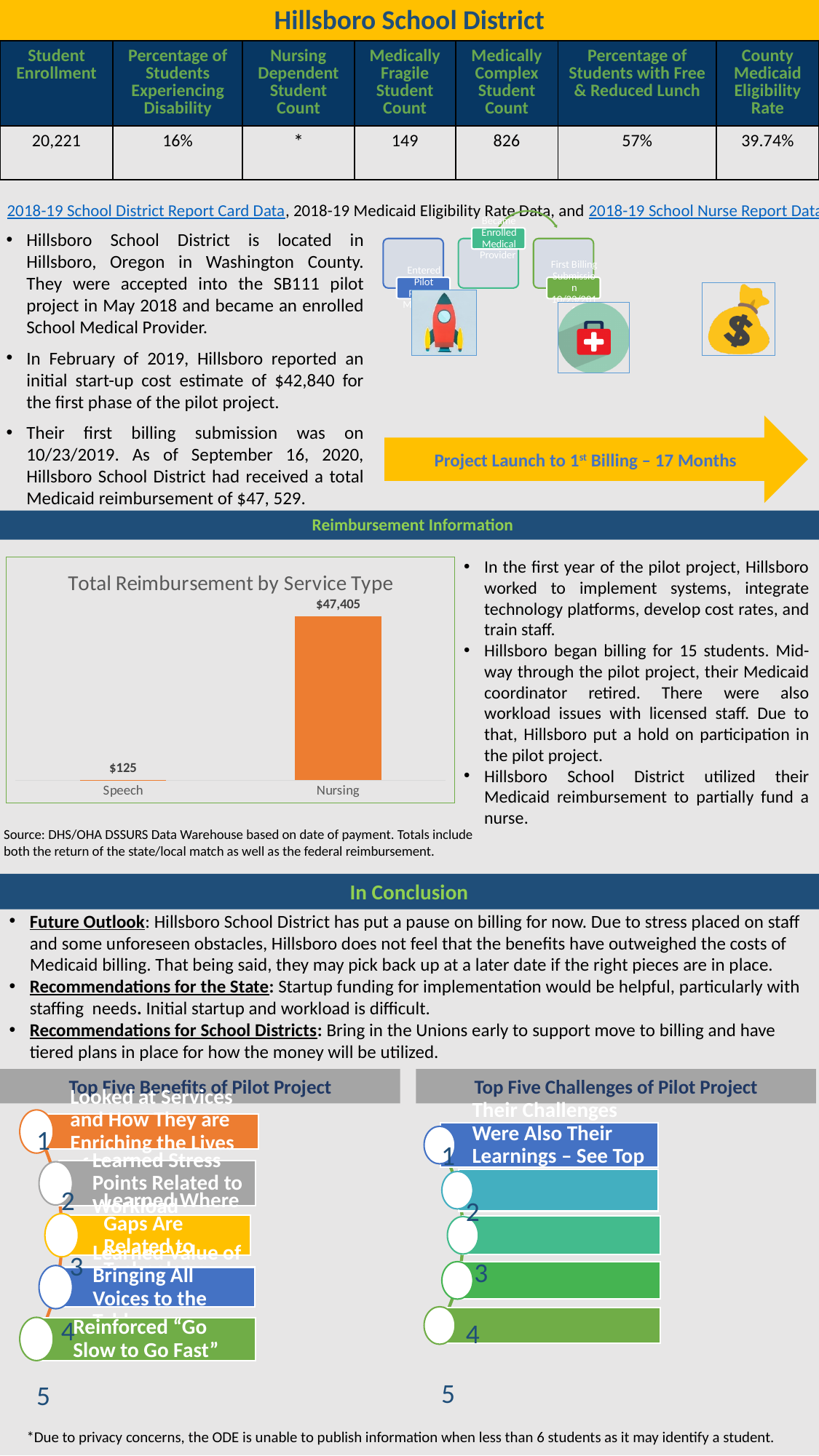
What is the title of the chart on the slide? Total Reimbursement by Service Type What colour are the bars in the "Total Reimbursement by Service Type" chart? orange What is the combined total of the two values shown in the "Total Reimbursement by Service Type" chart? $47,530 What kind of chart is "Total Reimbursement by Service Type"? bar chart Which service type has the highest total reimbursement in the chart? Nursing In the "Total Reimbursement by Service Type" chart, what is the difference between the Nursing and Speech values? $47,280 In the "Total Reimbursement by Service Type" chart, what is the value for Speech? $125 Do the values in the "Total Reimbursement by Service Type" chart rise or fall from Speech to Nursing? rise How many service type categories are shown in the "Total Reimbursement by Service Type" chart? 2 In the "Total Reimbursement by Service Type" chart, which is larger, the value for Speech or the value for Nursing? Nursing Which service type has the lowest total reimbursement in the chart? Speech In the "Total Reimbursement by Service Type" chart, what is the value for Nursing? $47,405